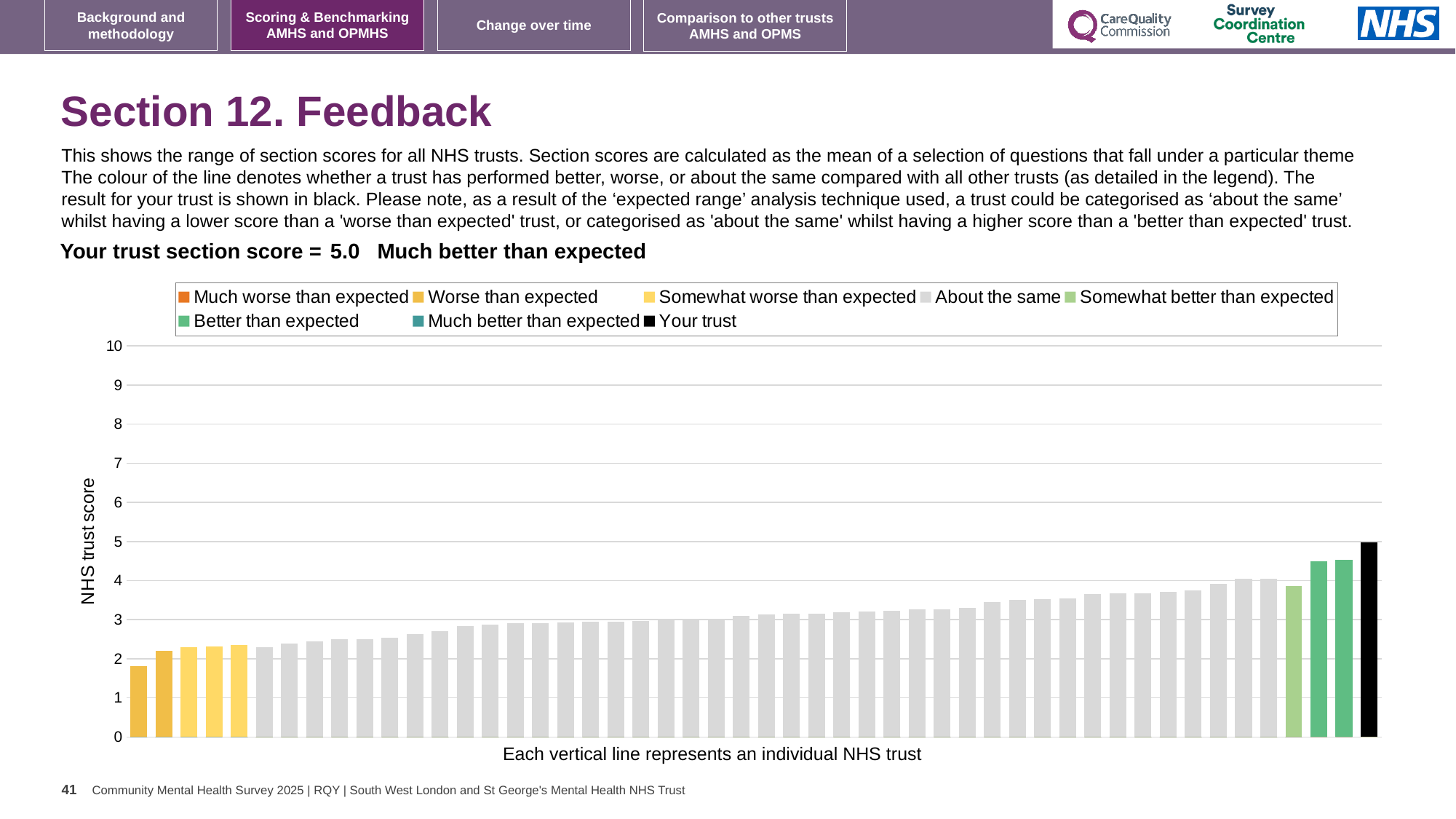
What kind of chart is shown on the slide? bar chart Is the value of the tallest green 'Better than expected' bar greater or less than 4? greater Is the value of the lowest bar in the chart greater or less than 2? less Do the bar values rise or fall from left to right across the chart? rise Which category does your trust's section score fall into, according to the slide? Much better than expected What is the label on the vertical axis of the chart? NHS trust score What colour is used for the 'Your trust' bar in the chart? black How many entries does the chart legend list? 8 Which legend category does the lowest bar in the chart belong to? Worse than expected Is the value of the tallest grey 'About the same' bar greater or less than 5? less Which bar in the chart is the tallest? Your trust (the black bar) What is the section score for your trust shown on the slide? 5.0